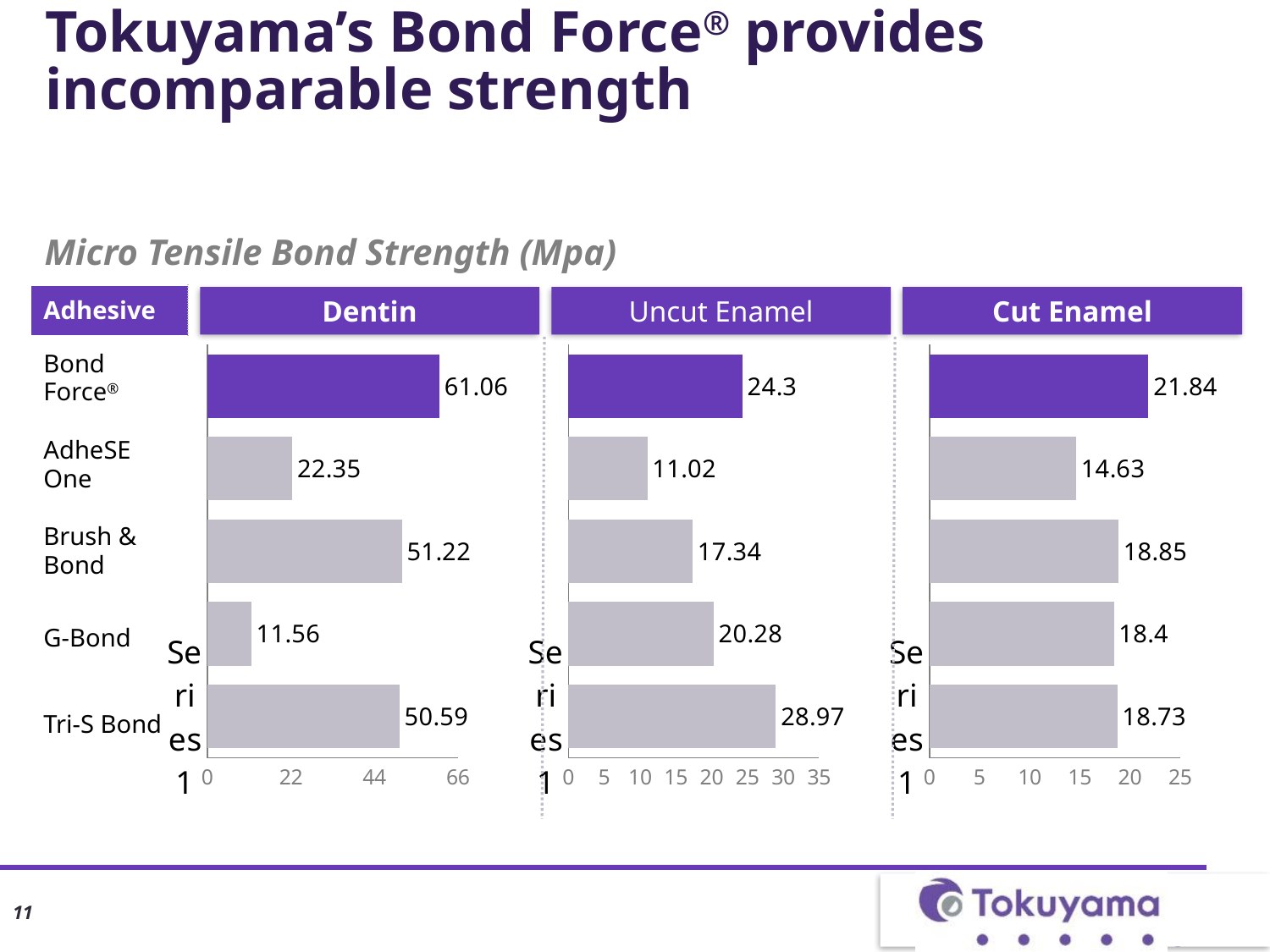
In the Uncut Enamel chart, what is the difference between the Tri-S Bond value and the AdheSE One value? 17.95 In the Dentin chart, what is the difference between the Bond Force value and the Brush & Bond value? 9.84 In the Cut Enamel chart, is the value for Bond Force greater or less than 20? greater What kind of chart is the Uncut Enamel chart? bar chart How many adhesives are plotted in the Dentin chart? 5 In the Uncut Enamel chart, which is larger, the value for G-Bond or the value for Brush & Bond? G-Bond In the Dentin chart, which adhesive has the lowest value? G-Bond In the Cut Enamel chart, which adhesive has the highest value? Bond Force In the Cut Enamel chart, what is the value for AdheSE One? 14.63 In the Uncut Enamel chart, what is the value for Tri-S Bond? 28.97 In the Uncut Enamel chart, which adhesive has the highest value? Tri-S Bond In the Dentin chart, what is the value for Bond Force? 61.06